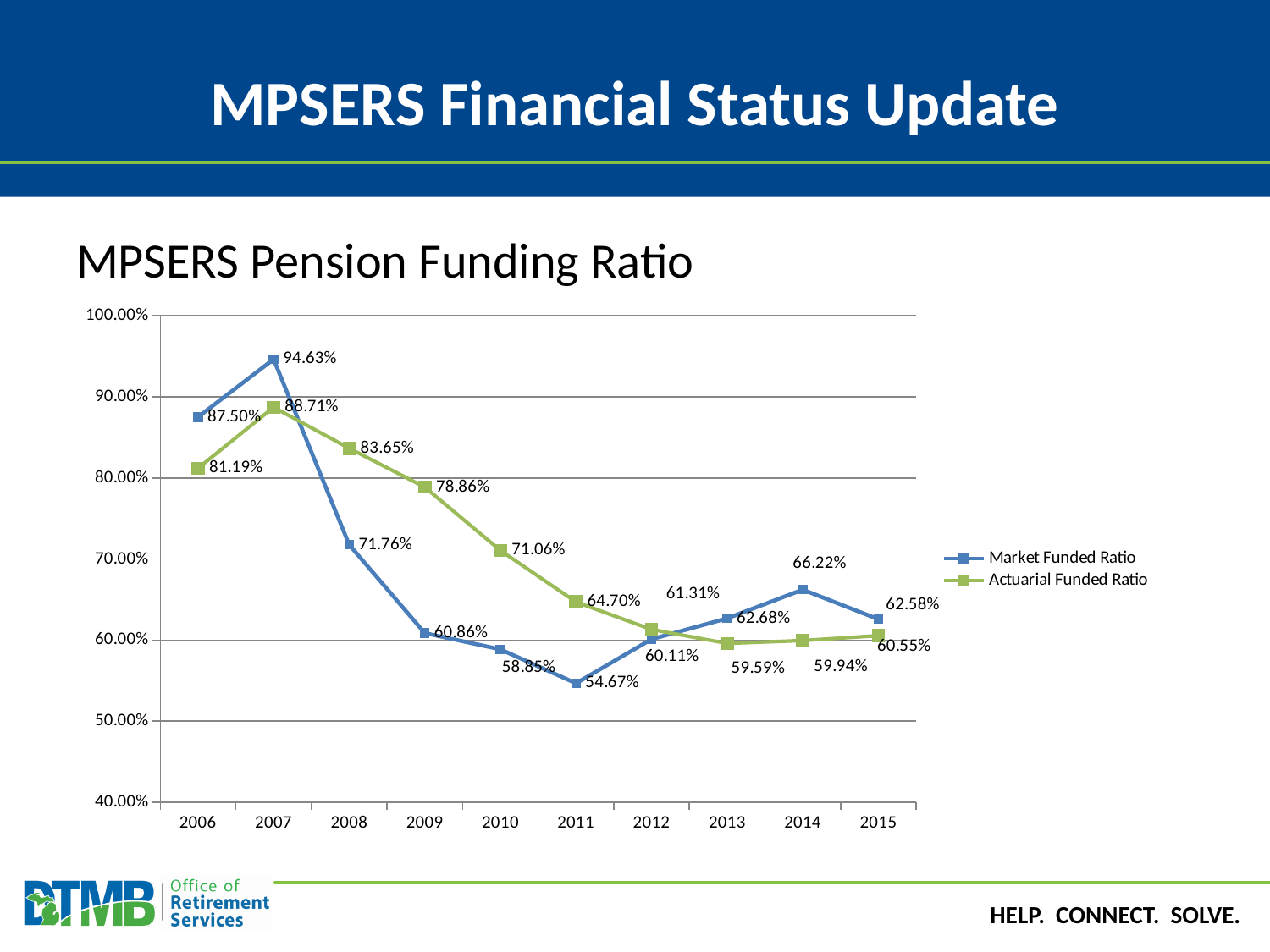
What is the Market Funded Ratio for 2007? 94.63% What is the Actuarial Funded Ratio for 2006? 81.19% How many years are shown on the x axis? 10 What type of chart is shown on the slide? Line chart In which year is the Market Funded Ratio lowest? 2011 What is the Actuarial Funded Ratio for 2009? 78.86% How many series does the legend list? 2 What is the Market Funded Ratio for 2011? 54.67% In which year is the Actuarial Funded Ratio lowest? 2013 In which year is the Market Funded Ratio highest? 2007 What is the difference between the Market Funded Ratio and the Actuarial Funded Ratio in 2008? 11.89% Which is larger in 2014, the Market Funded Ratio or the Actuarial Funded Ratio? Market Funded Ratio